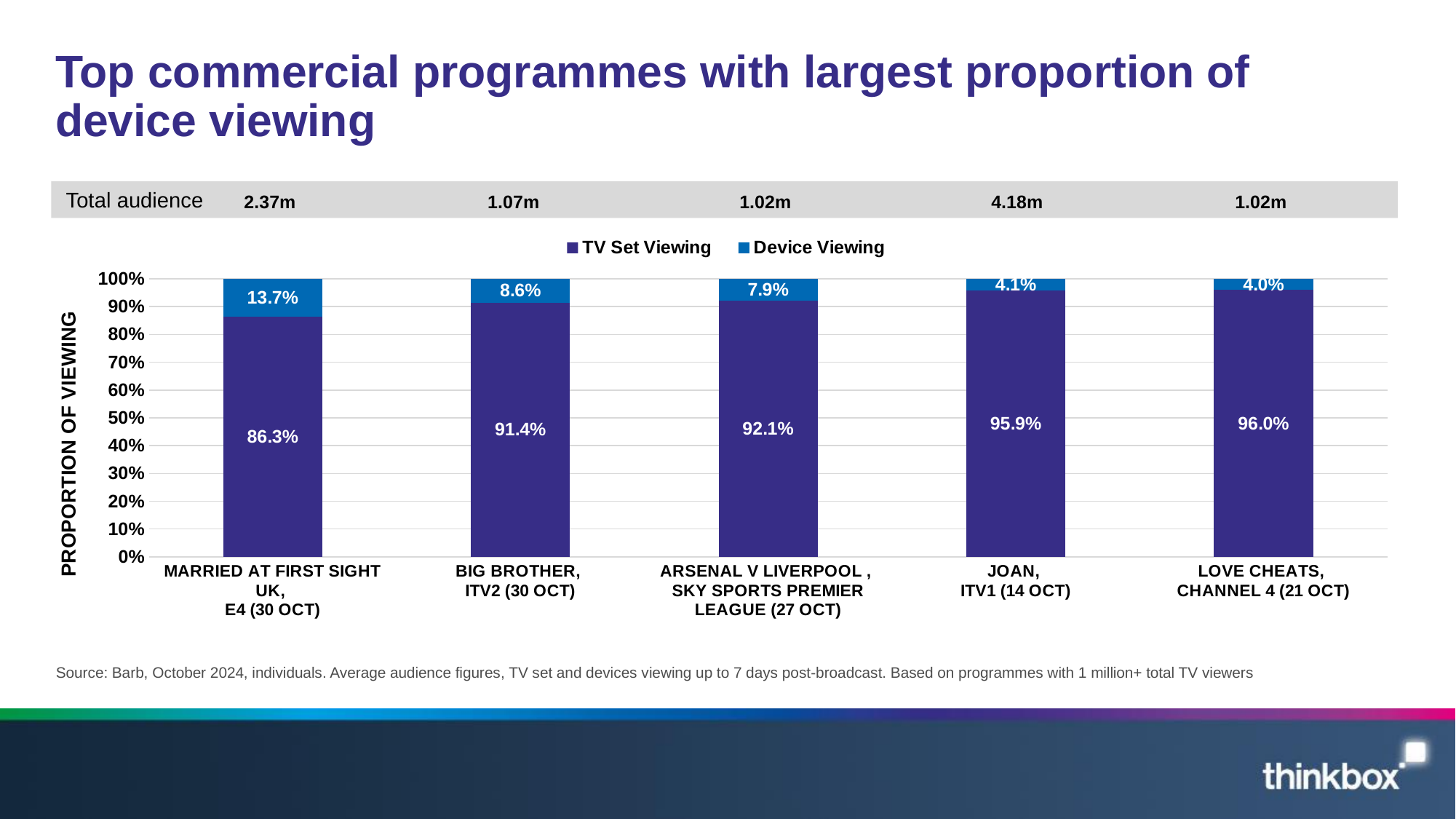
Which programme has the highest Device Viewing proportion? Married at First Sight UK, E4 (30 Oct) What is the TV Set Viewing proportion for Love Cheats, Channel 4 (21 Oct)? 96.0% Which programme has the lowest Device Viewing proportion? Love Cheats, Channel 4 (21 Oct) What is the Device Viewing proportion for Married at First Sight UK, E4 (30 Oct)? 13.7% What is the TV Set Viewing proportion for Big Brother, ITV2 (30 Oct)? 91.4% What is the difference in Device Viewing proportion between Married at First Sight UK and Big Brother? 5.1% How many programmes are shown on the chart? 5 How many series does the legend list? 2 Which has a larger TV Set Viewing proportion, Joan (ITV1) or Arsenal v Liverpool? Joan, ITV1 (14 Oct) What kind of chart is shown on the slide? Stacked bar chart What is the Device Viewing proportion for Arsenal v Liverpool, Sky Sports Premier League (27 Oct)? 7.9% What is the total audience shown for Joan, ITV1 (14 Oct)? 4.18m